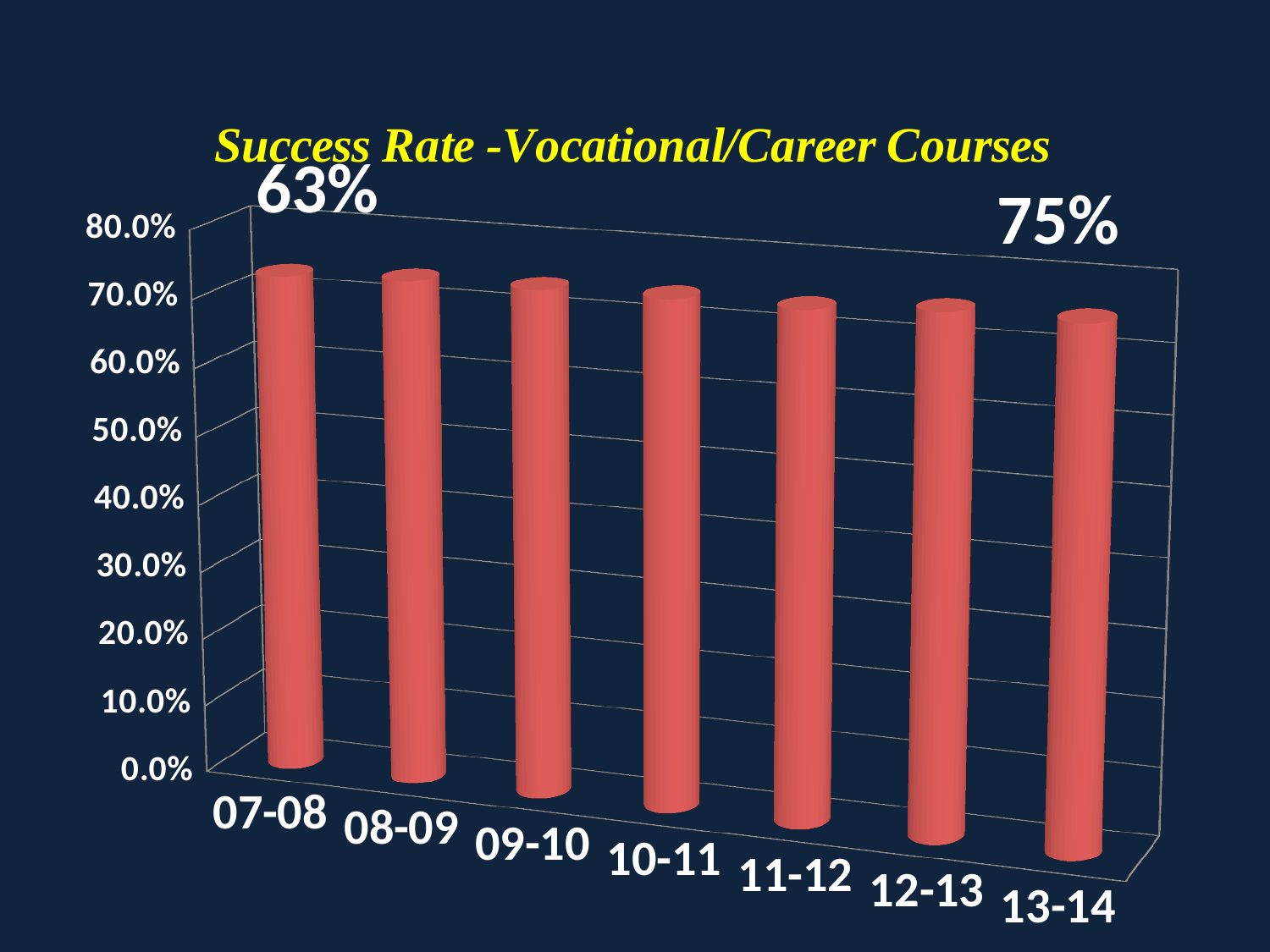
Is the value for 07-08 greater or less than 50.0%? greater What is the first category on the x axis? 07-08 What kind of chart is shown on the slide? bar chart What is the last category on the x axis? 13-14 How many academic years (categories) are plotted on the x axis? 7 What is the highest value shown on the y axis? 80.0% Is the value for 11-12 greater or less than 80.0%? less Is the value for 13-14 greater or less than 50.0%? greater What is the title of the chart? Success Rate -Vocational/Career Courses